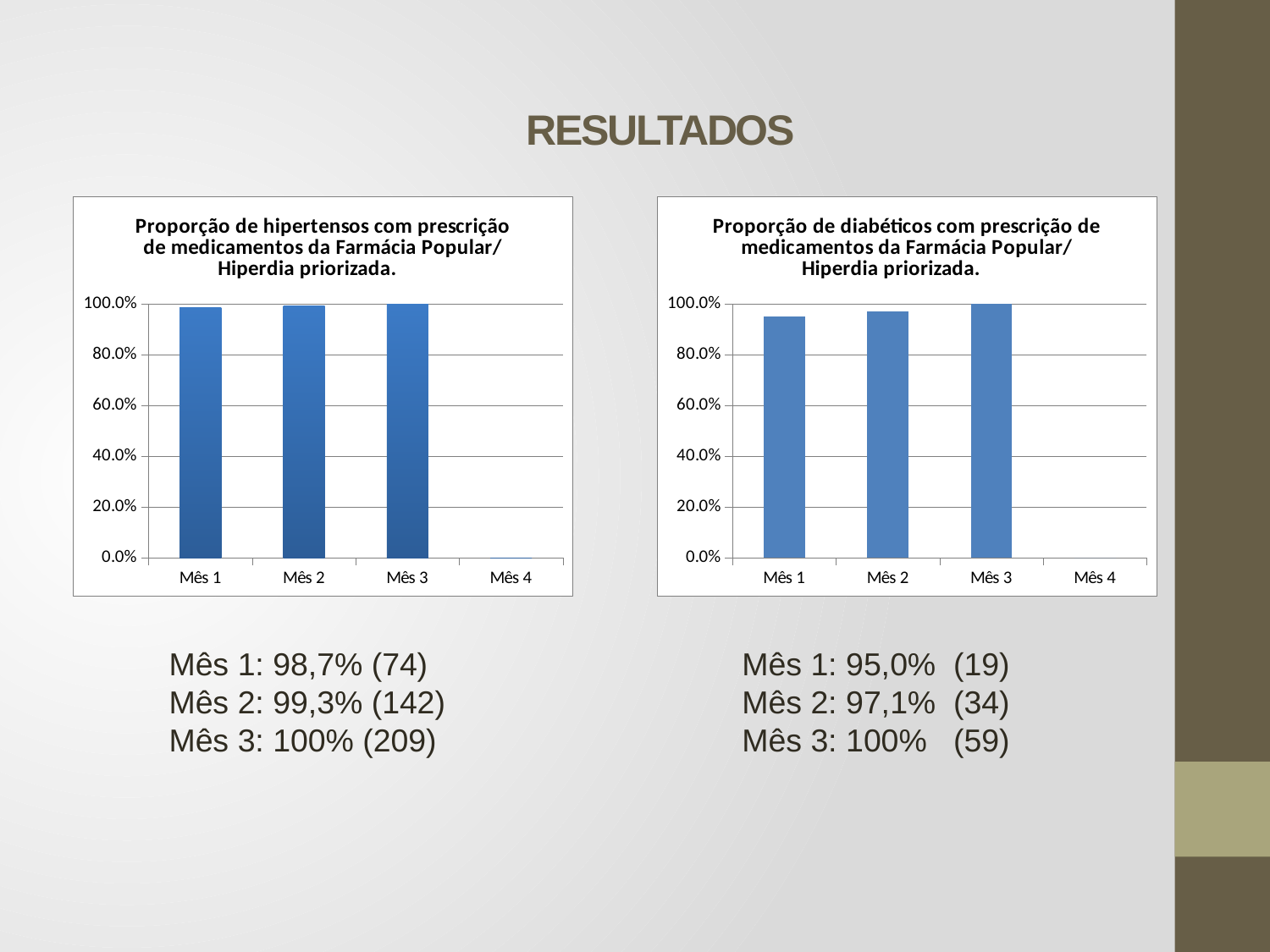
In the right chart (Proporção de diabéticos), which month has the lowest value? Mês 1 What kind of chart is the right chart (Proporção de diabéticos)? Bar chart In the right chart (Proporção de diabéticos), which is larger, the value for Mês 1 or Mês 3? Mês 3 In the right chart (Proporção de diabéticos), which month has the highest value? Mês 3 What is the title of the left chart? Proporção de hipertensos com prescrição de medicamentos da Farmácia Popular/ Hiperdia priorizada. In the left chart (Proporção de hipertensos), what is the value for Mês 2? 99,3% How many bars are plotted in the left chart (Proporção de hipertensos)? 3 In the left chart (Proporção de hipertensos), what is the difference between Mês 3 and Mês 1? 1,3% In the right chart (Proporção de diabéticos), is the value for Mês 1 greater or less than 80.0%? greater In the right chart (Proporção de diabéticos), what is the difference between Mês 3 and Mês 1? 5,0% In the right chart (Proporção de diabéticos), what is the value for Mês 1? 95,0% In the right chart (Proporção de diabéticos), do the values rise or fall from Mês 1 to Mês 3? Rise